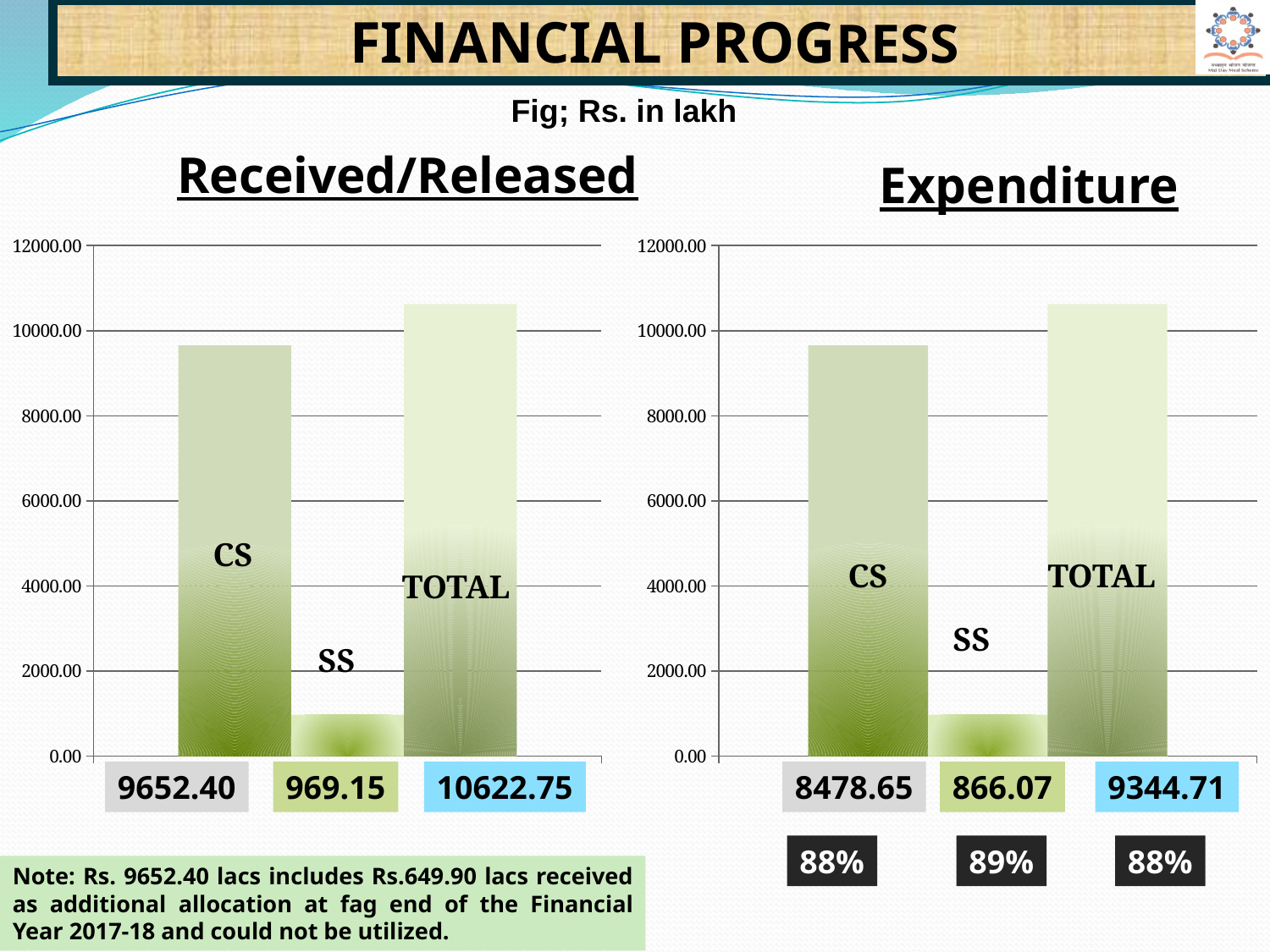
How many categories are shown in the Expenditure chart? 3 In the Received/Released chart, what is the value for CS? 9652.40 In the Expenditure chart, what is the value for SS? 866.07 In the Received/Released chart, is the value for CS greater or less than 8000.00? greater In the Expenditure chart, which category has the highest value? TOTAL In the Expenditure chart, what is the value for CS? 8478.65 In the Received/Released chart, what is the value for TOTAL? 10622.75 In the Received/Released chart, which category has the lowest value? SS What type of chart is the Received/Released chart? Bar chart In the Received/Released chart, what is the value for SS? 969.15 In the Received/Released chart, is the value for SS greater or less than 2000.00? less In the Expenditure chart, what is the value for TOTAL? 9344.71